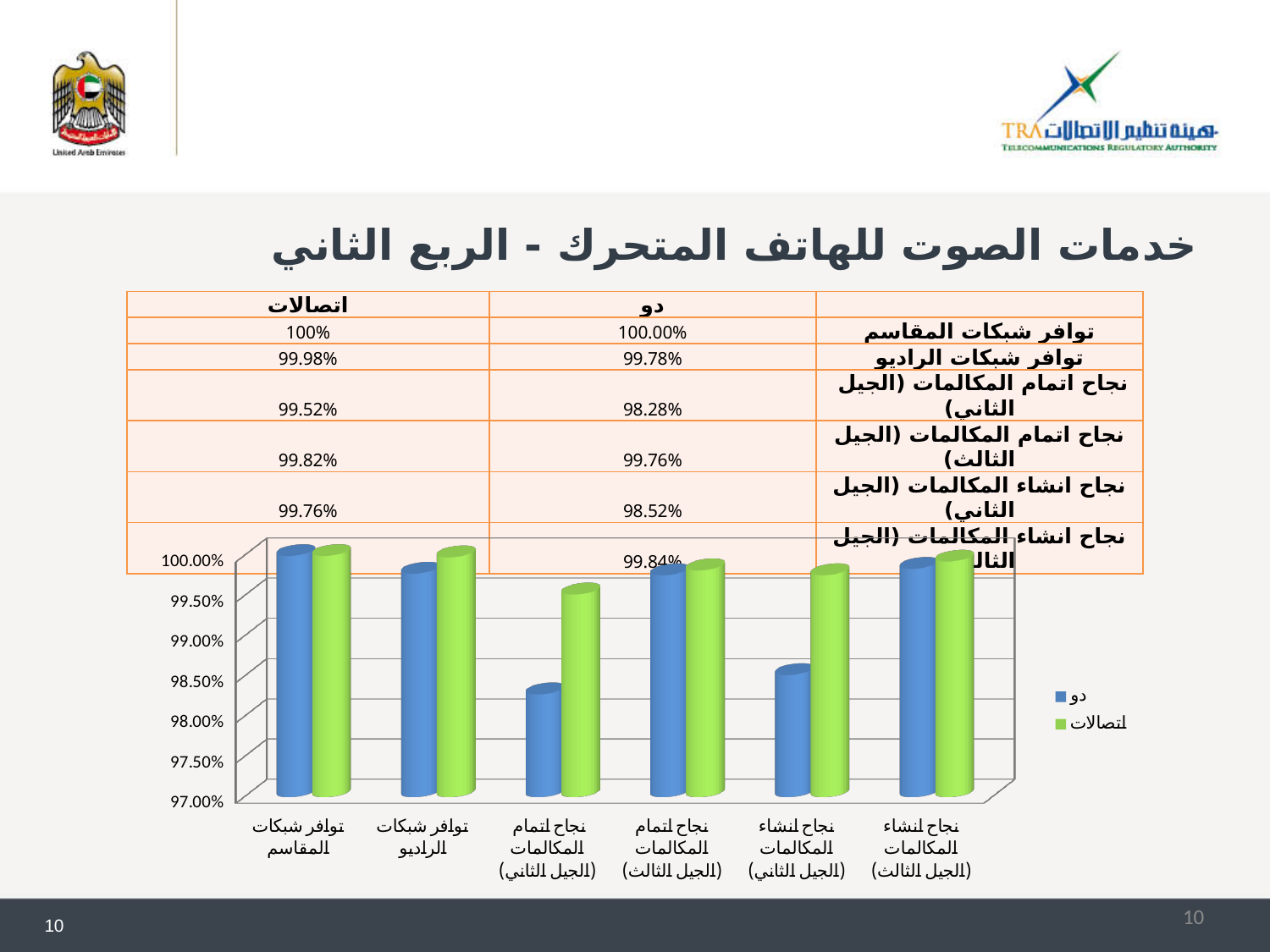
What is the value for اتصالات in the category نجاح اتمام المكالمات (الجيل الثاني)? 99.52% What colour are the bars for the دو series in the chart? blue What is the value for دو in the category توافر شبكات المقاسم? 100.00% Is the value for دو in نجاح انشاء المكالمات (الجيل الثاني) greater or less than 99.00%? less Which category has the lowest value for the دو series? نجاح اتمام المكالمات (الجيل الثاني) What kind of chart is shown on the slide? bar chart What is the value for دو in the category توافر شبكات الراديو? 99.78% Which category has the highest value for the دو series? توافر شبكات المقاسم What is the difference between the اتصالات and دو values for نجاح اتمام المكالمات (الجيل الثاني)? 1.24% How many series does the chart legend list? 2 How many categories are plotted along the x axis of the chart? 6 In the category نجاح انشاء المكالمات (الجيل الثاني), which series has the larger value, دو or اتصالات? اتصالات